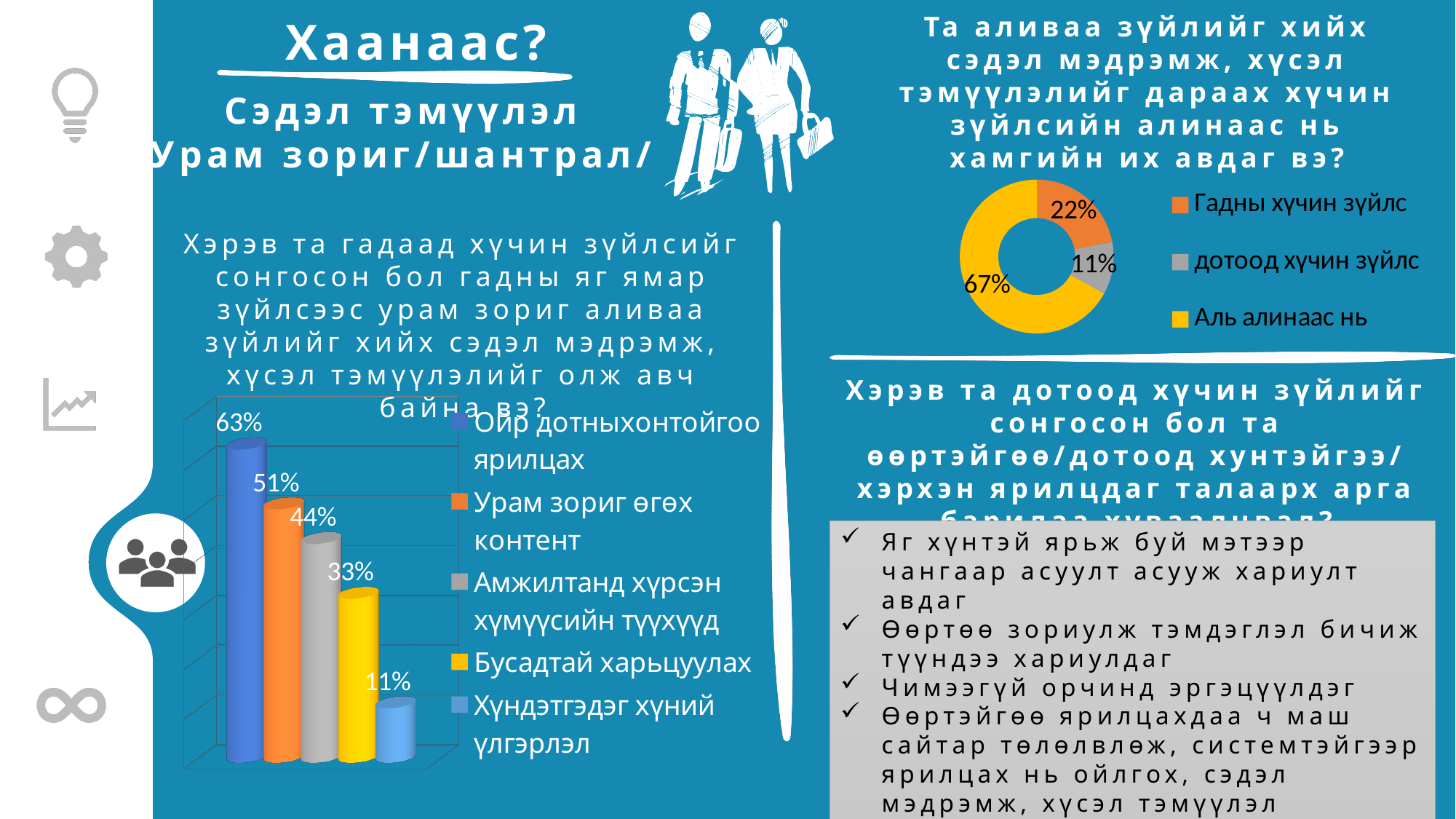
In the bar chart on the left, which category has the lowest value? Хүндэтгэдэг хүний үлгэрлэл In the bar chart on the left, what is the value for 'Бусадтай харьцуулах'? 33% In the doughnut chart on the right, which category has the smallest share? дотоод хүчин зүйлс In the doughnut chart on the right, what share is labelled for 'Аль алинаас нь'? 67% In the doughnut chart on the right, how many entries does the legend list? 3 In the bar chart on the left, how many bars are plotted? 5 What type of chart is shown at the bottom left of the slide? bar chart In the bar chart on the left, which category has the highest value? Ойр дотныхонтойгоо ярилцах In the doughnut chart on the right, what is the value for 'Гадны хүчин зүйлс'? 22% In the bar chart on the left, what is the difference between 'Урам зориг өгөх контент' and 'Амжилтанд хүрсэн хүмүүсийн түүхүүд'? 7% In the bar chart on the left, what is the value for 'Ойр дотныхонтойгоо ярилцах'? 63% In the doughnut chart on the right, what is the difference between the shares for 'Гадны хүчин зүйлс' and 'дотоод хүчин зүйлс'? 11%